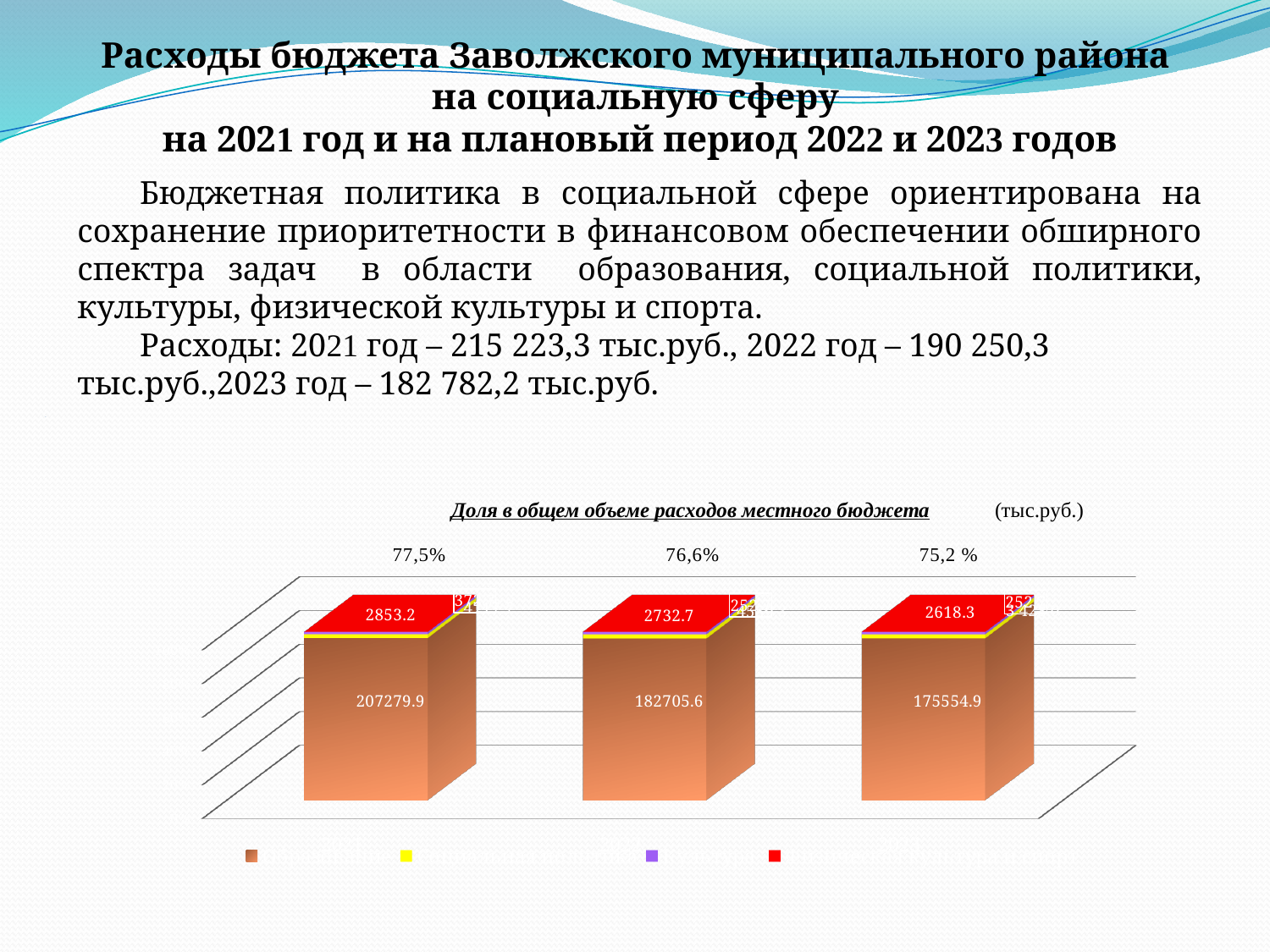
What is the value printed on the large brown segment of the left bar? 207279.9 What is the value printed on the red top segment of the left bar? 2853.2 What is the difference between the brown segment values of the left bar and the middle bar? 24574.3 Do the brown segment values rise or fall from the left bar to the right bar? fall How many series does the chart legend list? 4 What percentage is printed above the left bar? 77,5% How many bars are plotted in the chart? 3 What is the value printed on the red top segment of the right bar? 2618.3 What is the value printed on the large brown segment of the middle bar? 182705.6 What kind of chart is shown on the slide? bar chart Which bar has the highest value for the brown segment: left, middle or right? left What is the value printed on the large brown segment of the right bar? 175554.9